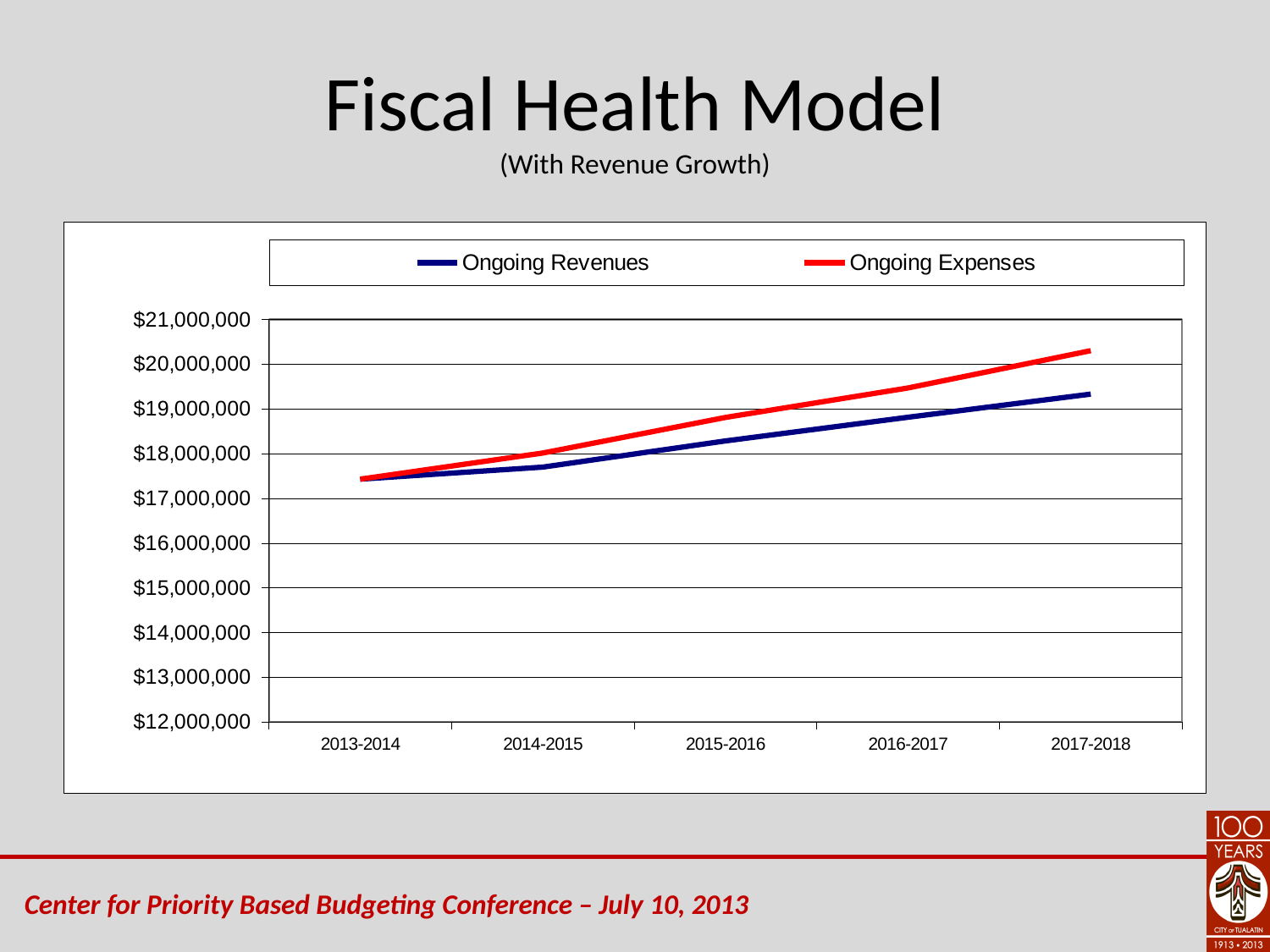
Is the value for Ongoing Expenses in 2017-2018 greater or less than $20,000,000? greater In which year are Ongoing Expenses highest? 2017-2018 In 2017-2018, which is larger: Ongoing Revenues or Ongoing Expenses? Ongoing Expenses How many fiscal years are plotted along the x axis? 5 In which year are Ongoing Revenues lowest? 2013-2014 How many series does the chart's legend list? 2 Is the value for Ongoing Revenues in 2013-2014 greater or less than $18,000,000? less Do Ongoing Revenues rise or fall across the years shown? Rise What is the subtitle shown under the title 'Fiscal Health Model'? (With Revenue Growth) Which series is drawn in red? Ongoing Expenses Do Ongoing Expenses rise or fall from 2013-2014 to 2017-2018? Rise What kind of chart is shown on the slide? Line chart